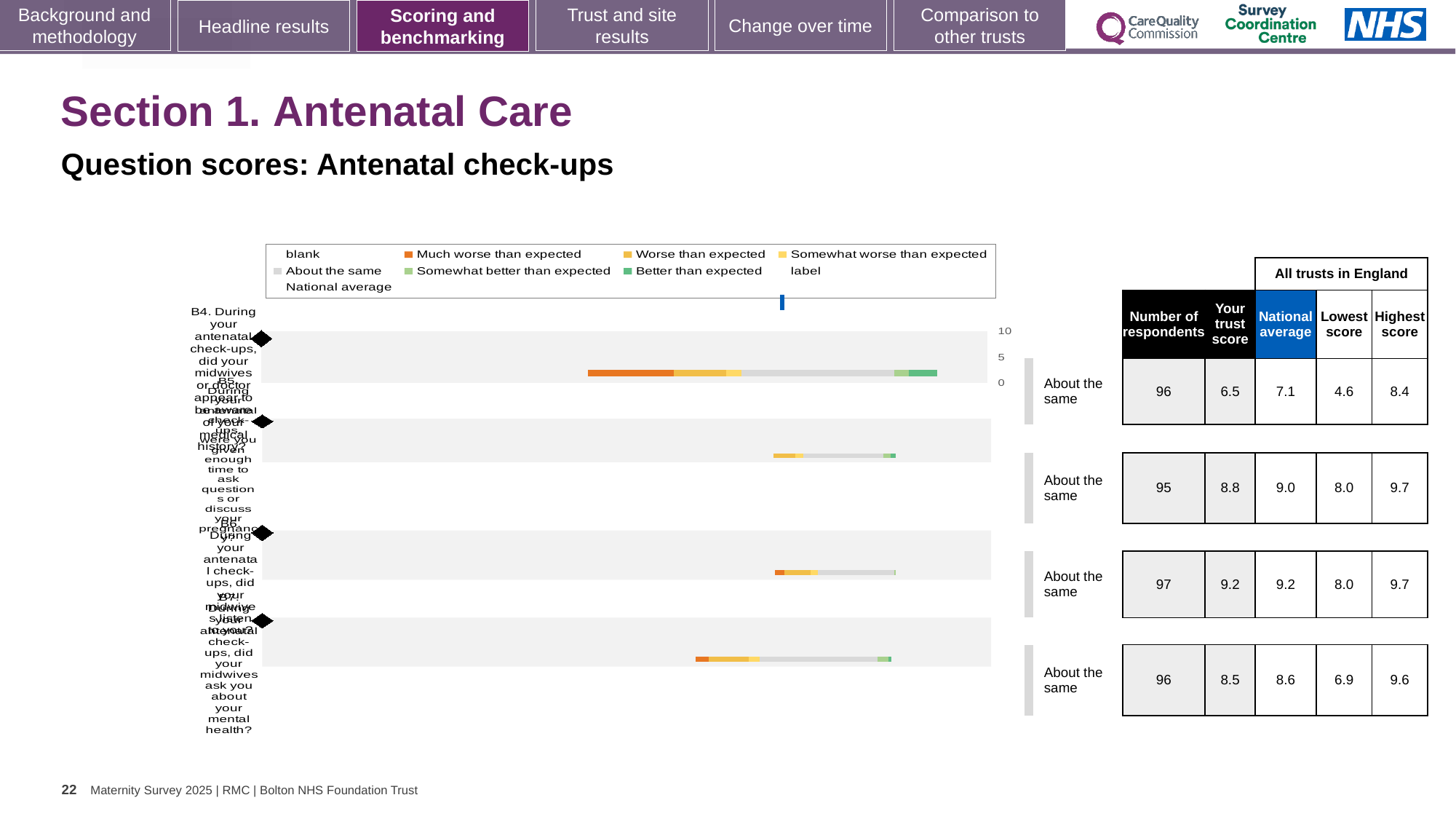
What is the national average for the third question, B6? 9.2 What colour does the legend use for 'Much worse than expected'? Orange Which question has the highest trust score in the table? B6 What is the trust score for the second question, B5, in the table? 8.8 How many questions (bars) are plotted in the antenatal check-ups chart? 4 In the table next to the chart, what is the number of respondents for the first question, B4? 96 Which question has the lowest trust score in the table? B4 For question B4, what is the difference between the highest score (8.4) and the lowest score (4.6) across all trusts? 3.8 What kind of chart is used to show the question scores for antenatal check-ups? bar chart For question B5, which is larger: the trust score or the national average? National average What benchmark category is shown for each of the four questions on this slide? About the same What is the lowest score across all trusts in England for the fourth question, B7? 6.9